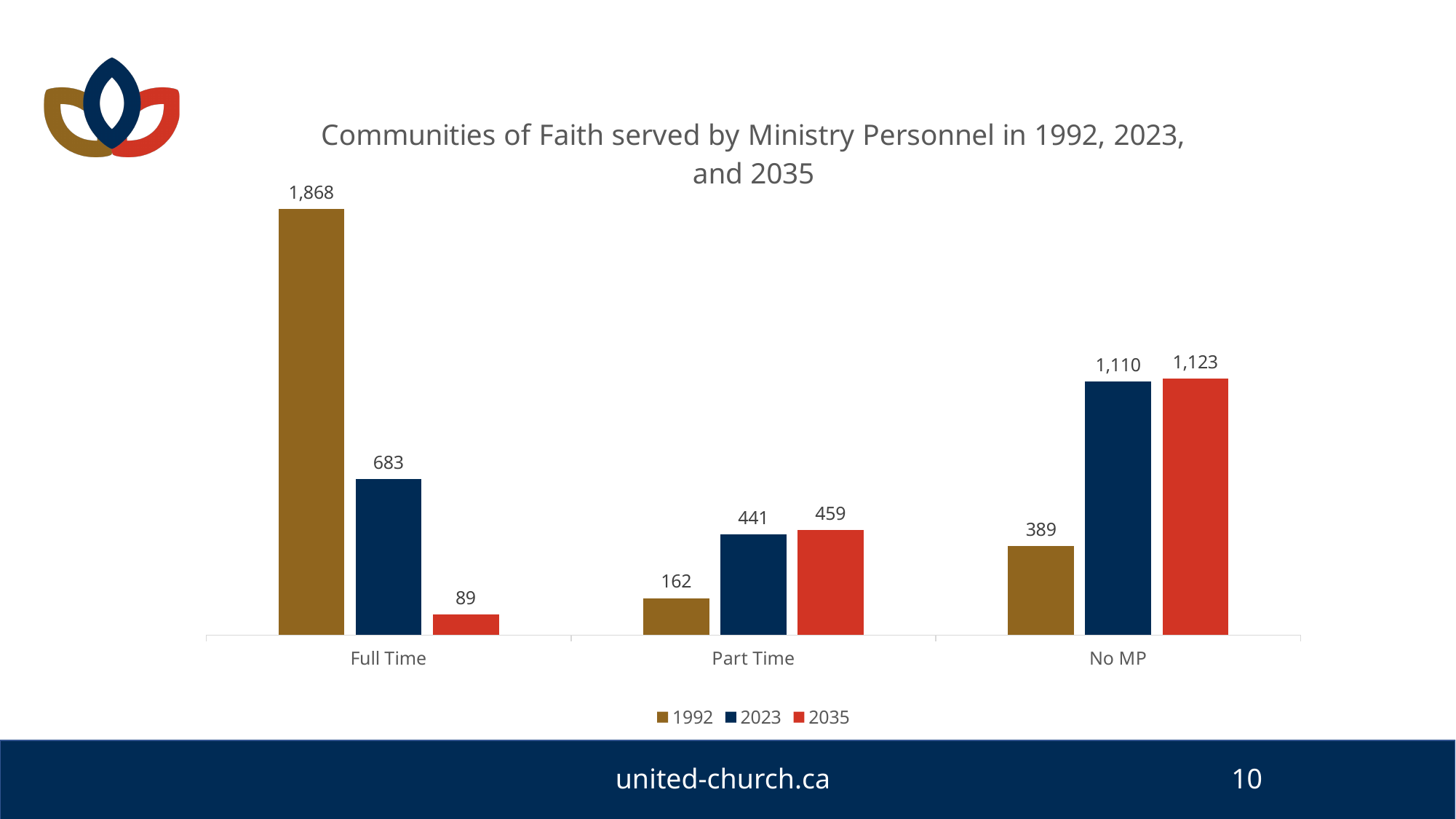
Which is larger: the Full Time value for 2035 or the Part Time value for 1992? Part Time value for 1992 What is the value for Part Time in 2023? 441 What is the difference between the Full Time values for 1992 and 2023? 1,185 What is the value for Full Time in 1992? 1,868 What is the title of the chart? Communities of Faith served by Ministry Personnel in 1992, 2023, and 2035 Which category has the lowest value for the 1992 series? Part Time What kind of chart is shown on the slide? Bar chart How many series does the legend list? 3 Which category has the highest value for the 2035 series? No MP How many categories are shown on the x axis? 3 Do the values for the 1992 series rise or fall from Full Time to Part Time? Fall What is the value for No MP in 2035? 1,123